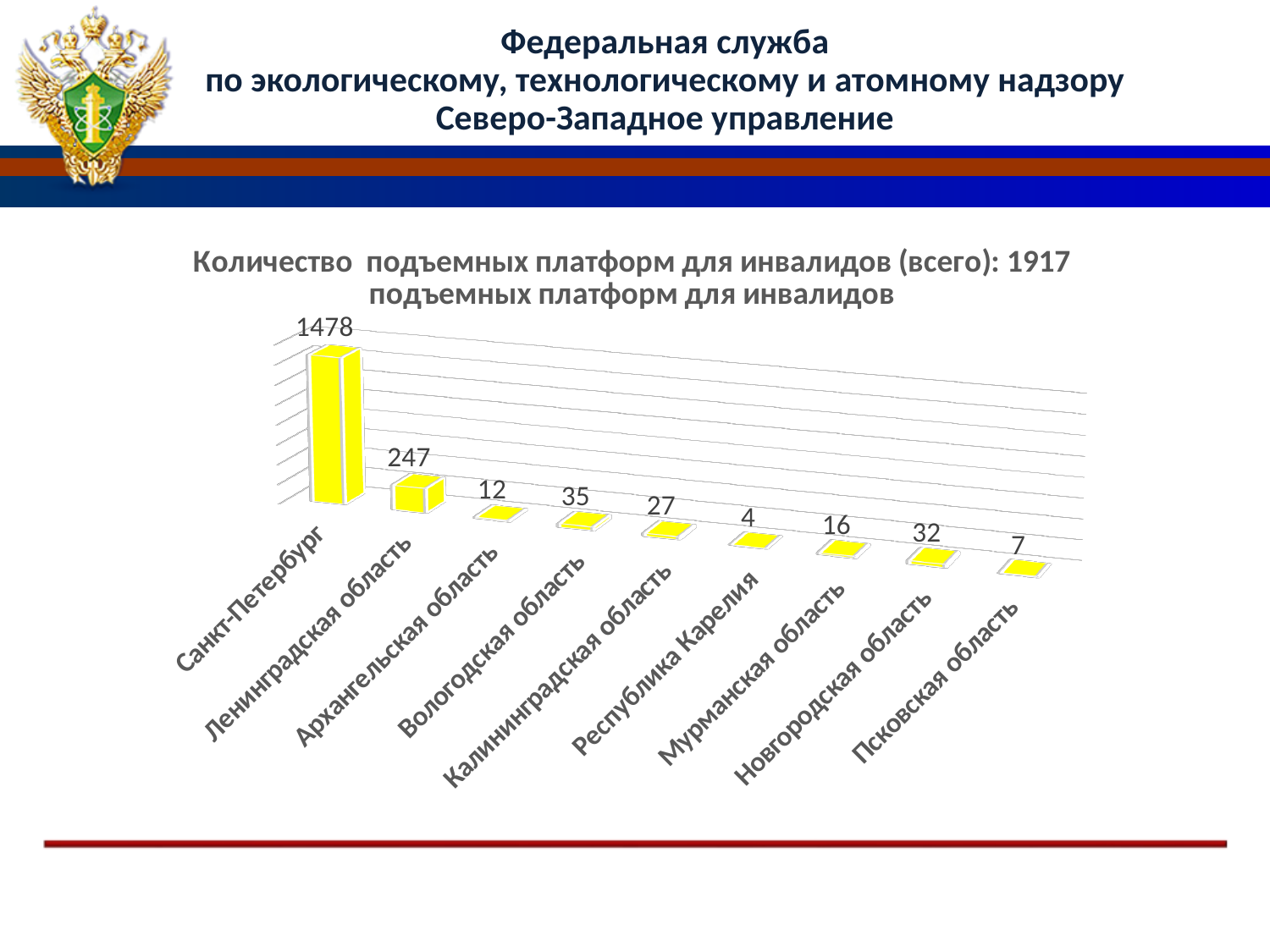
What is the value for Новгородская область? 32 What is the value for Санкт-Петербург? 1478 Which category has the highest value? Санкт-Петербург What is the difference between the values for Мурманская область and Псковская область? 9 What is the value for Республика Карелия? 4 Which is larger, the value for Вологодская область or the value for Калининградская область? Вологодская область What is the difference between the values for Санкт-Петербург and Ленинградская область? 1231 What is the value for Ленинградская область? 247 What total number of lifting platforms is stated in the chart title? 1917 Which category has the lowest value? Республика Карелия How many categories are shown on the chart? 9 What kind of chart is shown on the slide? bar chart